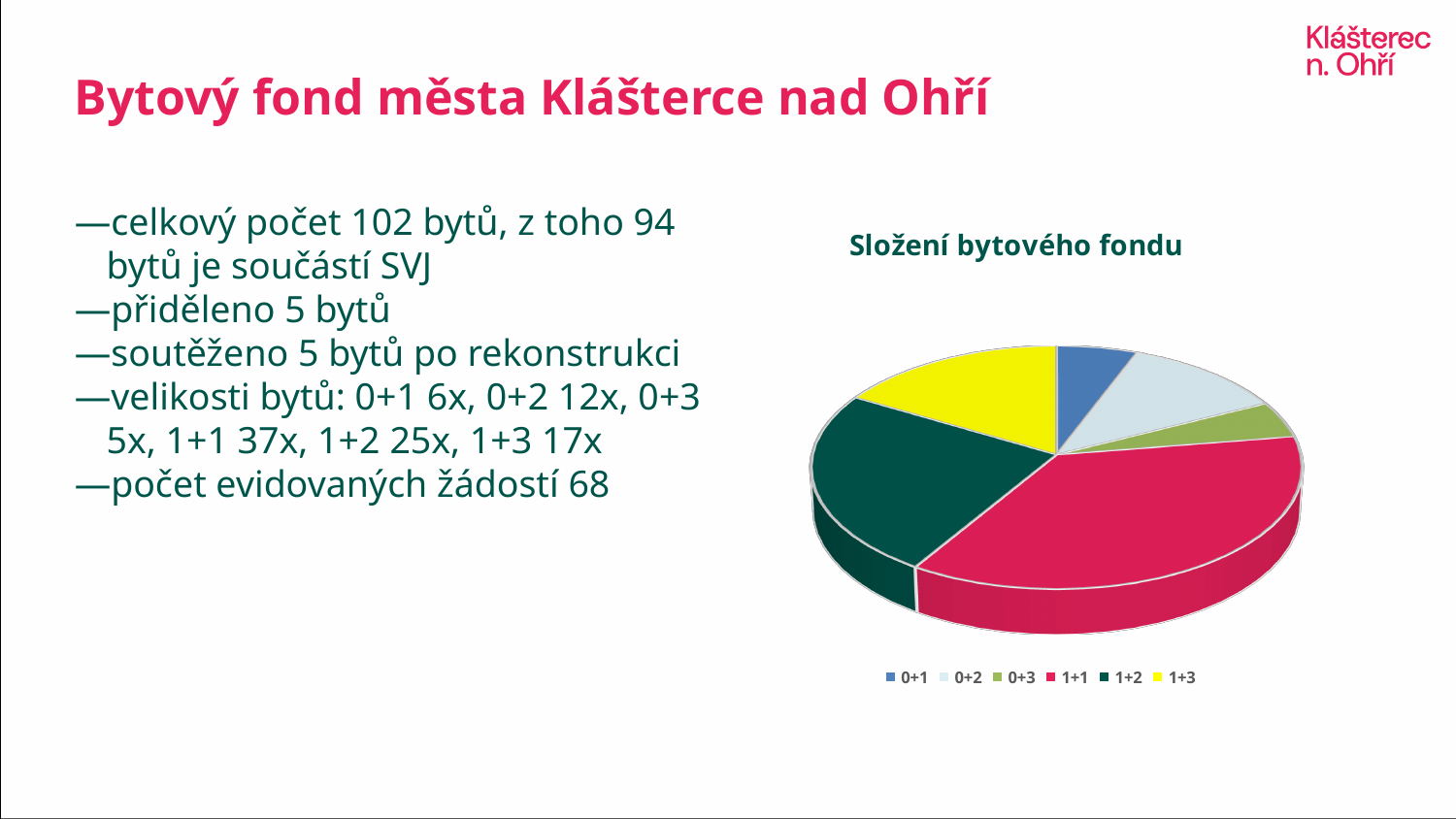
According to the slide, how many flats of size 1+1 are there? 37 Which slice is larger, 1+1 or 1+2? 1+1 According to the slide, how many flats of size 0+2 are there? 12 How many slices does the pie chart have? 6 What kind of chart is shown on the slide? pie chart How many entries does the chart legend list? 6 What is the title of the chart? Složení bytového fondu Which slice is larger, 1+2 or 1+3? 1+2 According to the slide, which flat size has the fewest flats? 0+3 What colour is the slice for 1+1 in the pie chart? red Which category has the largest slice of the pie? 1+1 Which slice is larger, 0+2 or 0+1? 0+2